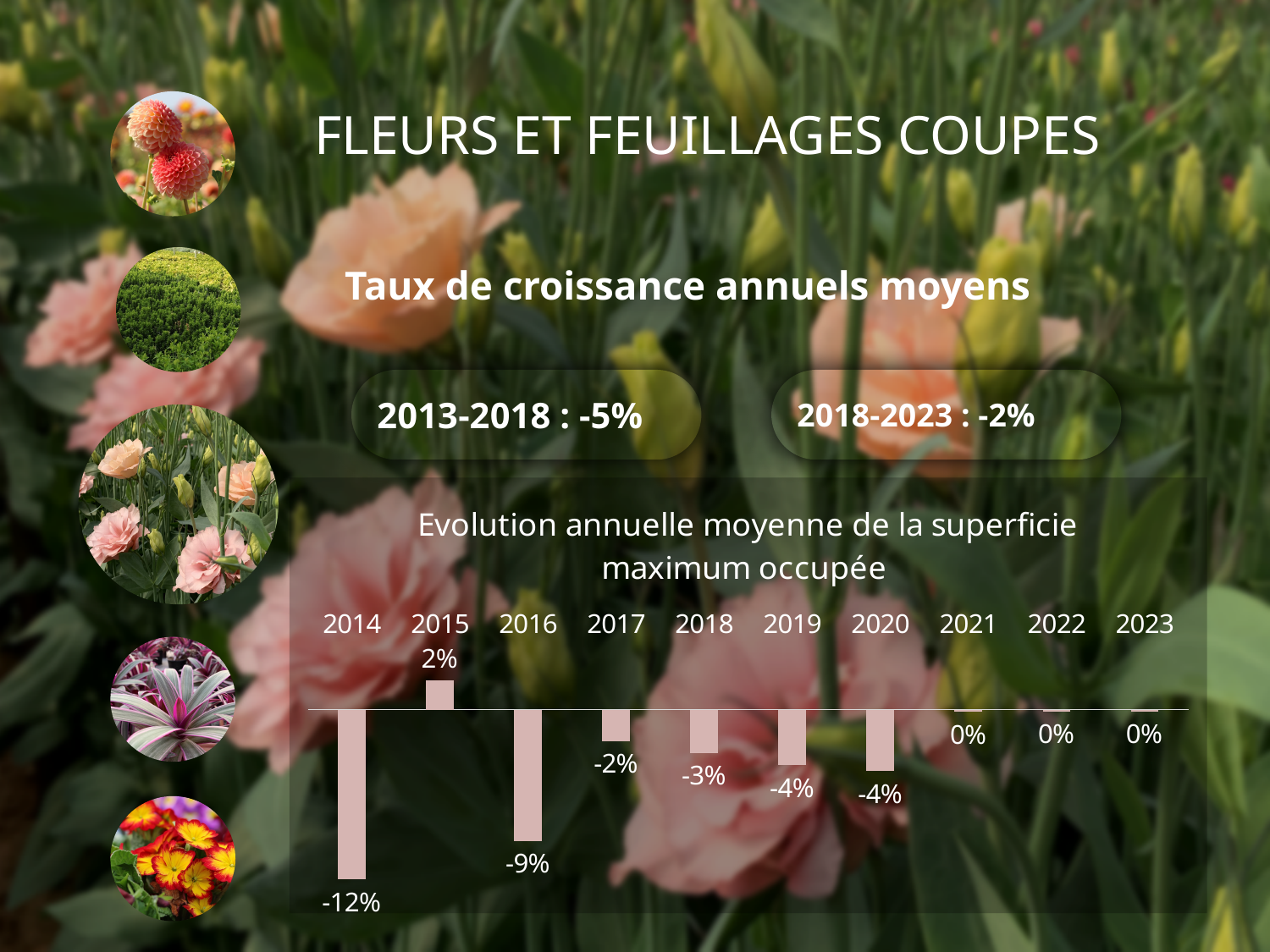
What kind of chart is shown on the slide? Bar chart What is the title of the chart? Evolution annuelle moyenne de la superficie maximum occupée What is the value for 2018 in the chart? -3% What is the value for 2016 in the chart? -9% What is the value for 2022 in the chart? 0% Which year has the highest value in the chart? 2015 How many years are shown on the x axis of the chart? 10 What is the difference between the values for 2014 and 2016? 3 percentage points What is the value for 2014 in the chart? -12% Which is larger, the value for 2017 or the value for 2019? 2017 What is the value for 2015 in the chart? 2% Which year has the lowest value in the chart? 2014